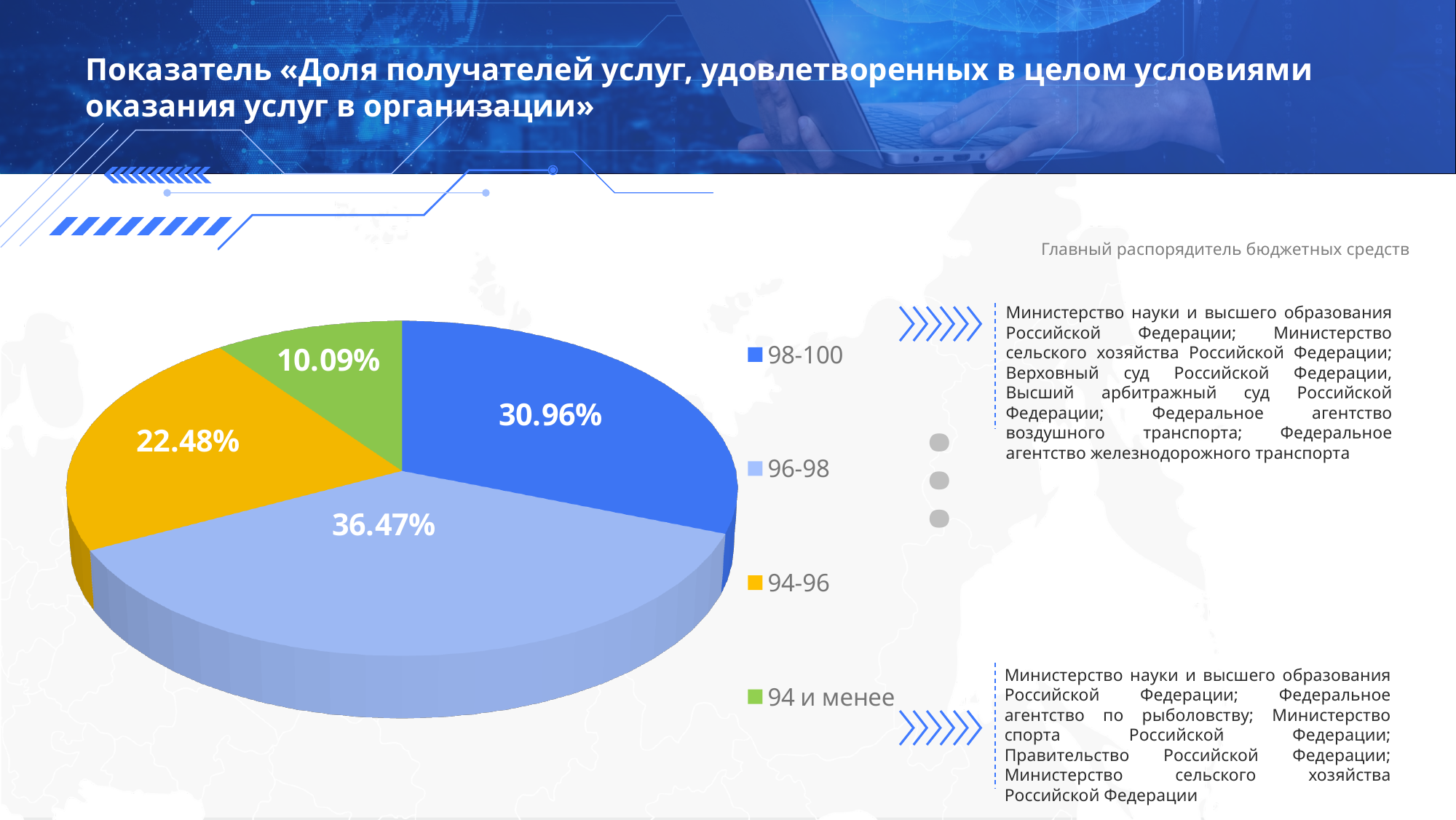
What type of chart is shown on the slide? Pie chart Which category has the smallest slice of the pie? 94 и менее How many categories are shown in the pie chart? 4 What is the value shown for the '94 и менее' category? 10.09% What is the value shown for the 94-96 category? 22.48% What share of the pie does the 96-98 slice represent? 36.47% What is the difference between the 96-98 slice and the 98-100 slice? 5.51% What is the value shown for the 98-100 category? 30.96% What is the difference between the 94-96 slice and the '94 и менее' slice? 12.39% Which category has the largest slice of the pie? 96-98 What colour is the slice for the 94-96 category? Yellow Which is larger, the 98-100 slice or the 94-96 slice? 98-100